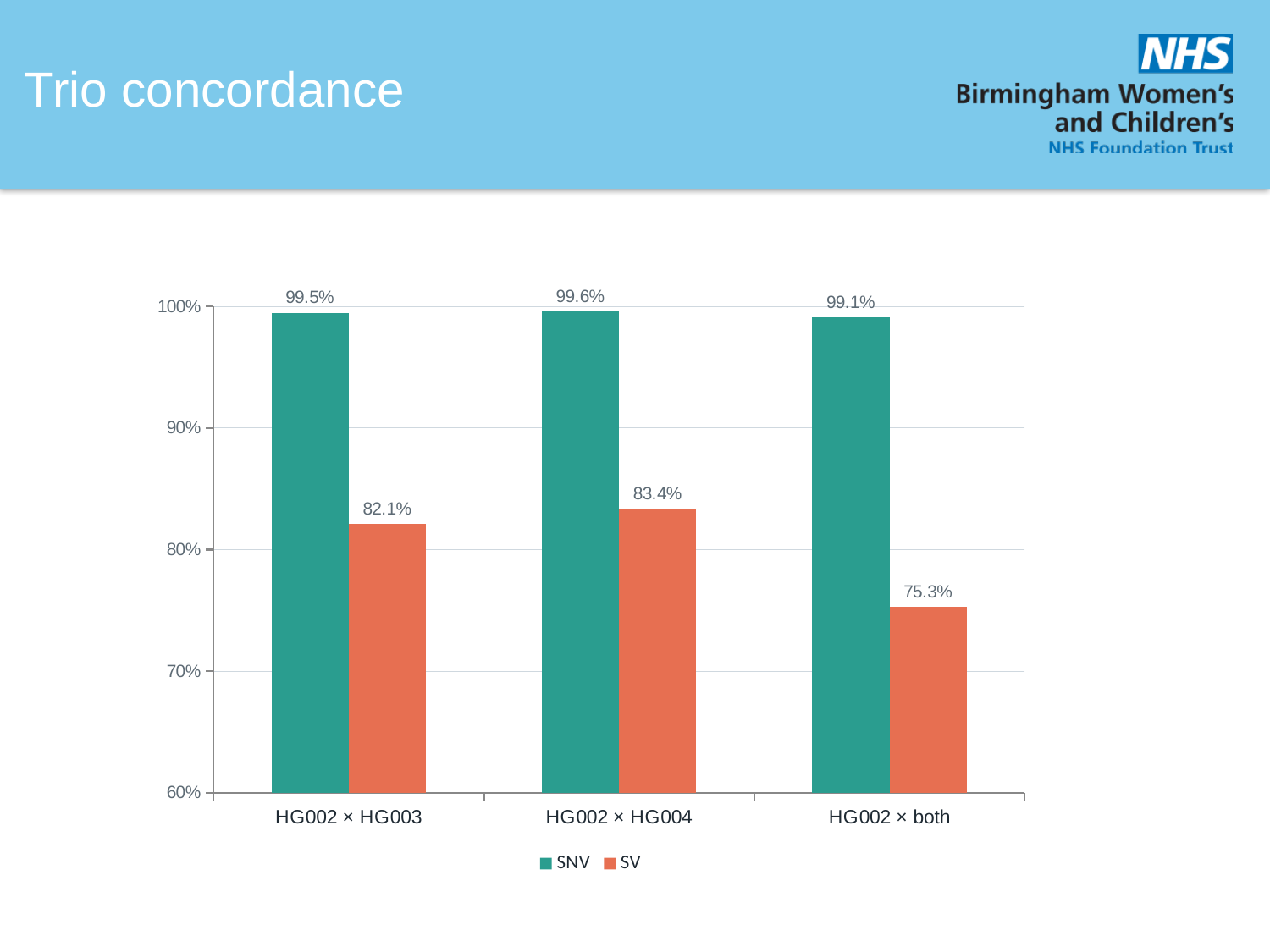
How many series does the legend list? 2 What is the SV value for HG002 × HG004? 83.4% What is the SV value for HG002 × both? 75.3% Which is larger, the SV value for HG002 × HG003 or the SV value for HG002 × HG004? HG002 × HG004 What is the SNV value for HG002 × HG003? 99.5% Which category has the lowest SV value? HG002 × both What kind of chart is shown on the slide? bar chart How many categories are shown on the x axis? 3 What colour are the SV bars? orange Is the SV value for HG002 × both greater or less than 80%? less Which category has the highest SNV value? HG002 × HG004 What is the difference between the SNV and SV values for HG002 × HG003? 17.4%